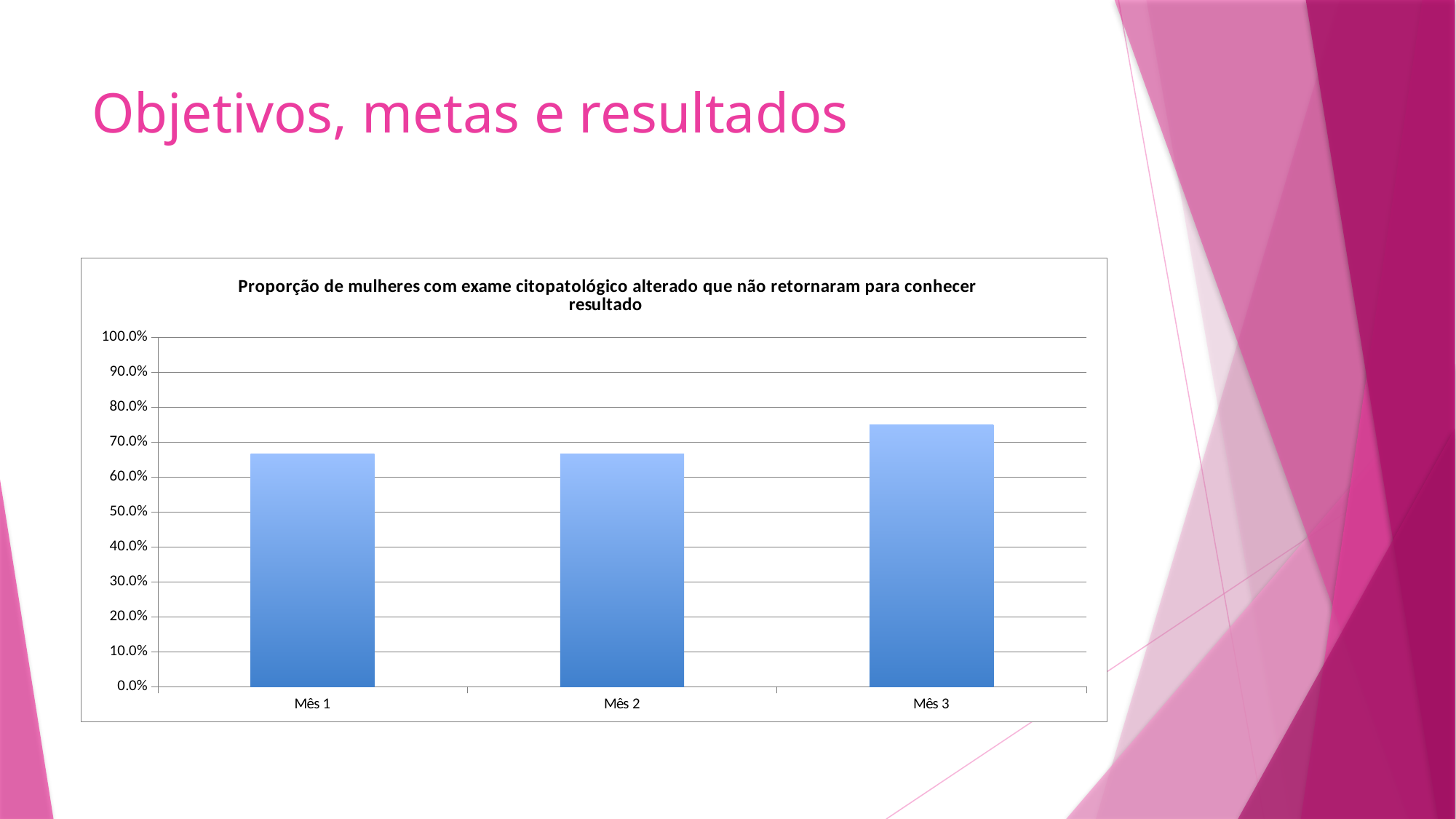
Do the values rise or fall from Mês 1 to Mês 3? rise How many categories (months) are plotted on the chart? 3 Which month has the highest value on the chart? Mês 3 What is the title of the chart? Proporção de mulheres com exame citopatológico alterado que não retornaram para conhecer resultado Is the value for Mês 1 greater or less than 70.0%? less What kind of chart is shown on the slide? bar chart Which is larger, the value for Mês 1 or the value for Mês 3? Mês 3 Is the value for Mês 2 greater or less than 70.0%? less Is the value for Mês 3 greater or less than 70.0%? greater What is the maximum value shown on the vertical axis of the chart? 100.0%